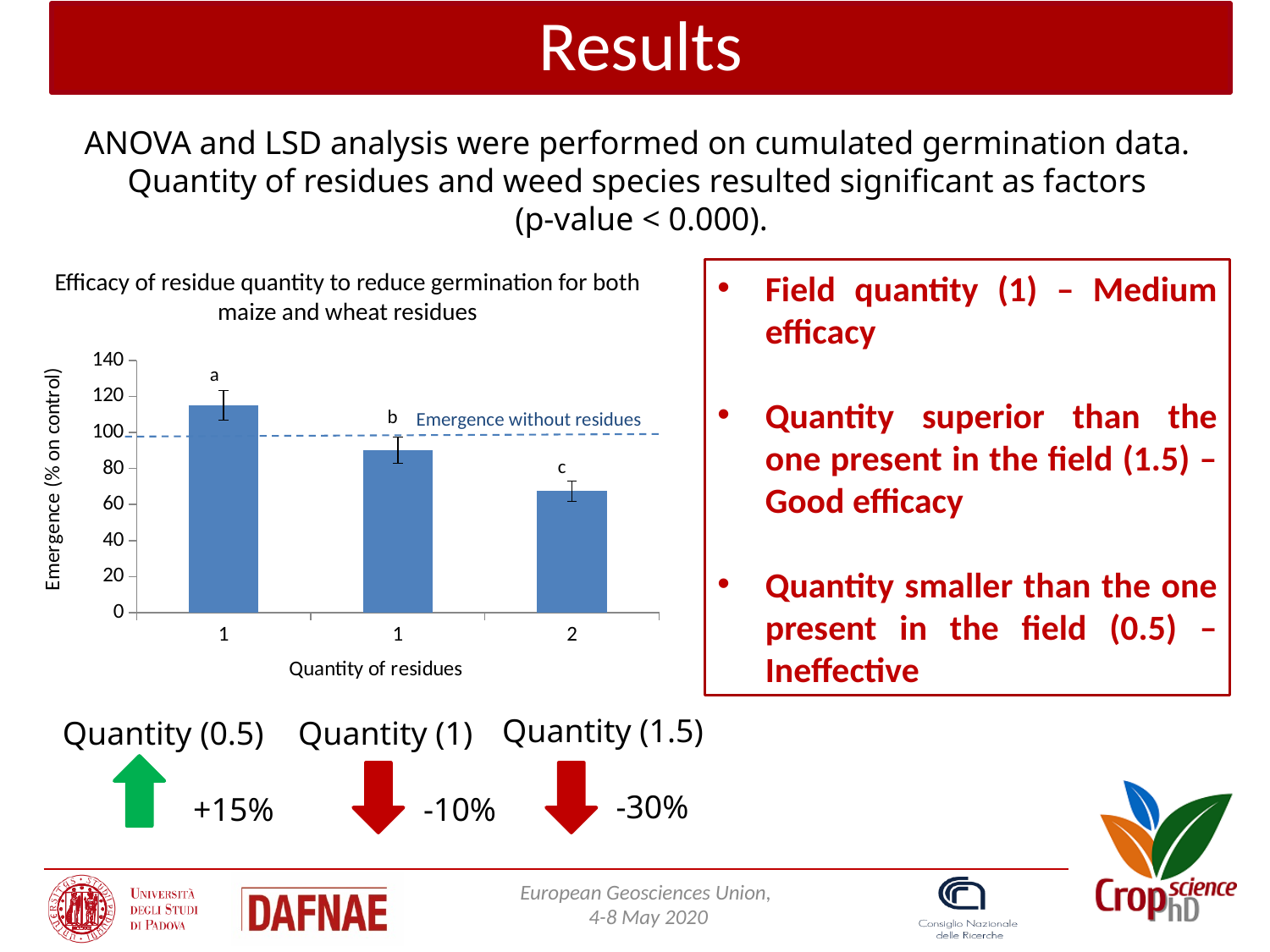
What kind of chart is shown on the slide? bar chart What is the title of the chart? Efficacy of residue quantity to reduce germination for both maize and wheat residues Which is larger: the bar labelled b or the bar labelled c? b Which bar is the highest in the chart: the one labelled a, b or c? a Do the bar values rise or fall from left to right along the x axis? fall Is the value of the leftmost bar (labelled a) greater or less than 100? greater Which bar is the lowest in the chart: the one labelled a, b or c? c Is the value of the middle bar (labelled b) greater or less than 100? less What value on the y axis does the dashed line labelled 'Emergence without residues' sit at? 100 What is the label of the y axis of the chart? Emergence (% on control) How many bars are plotted in the chart? 3 Is the value of the rightmost bar (labelled c) greater or less than 80? less